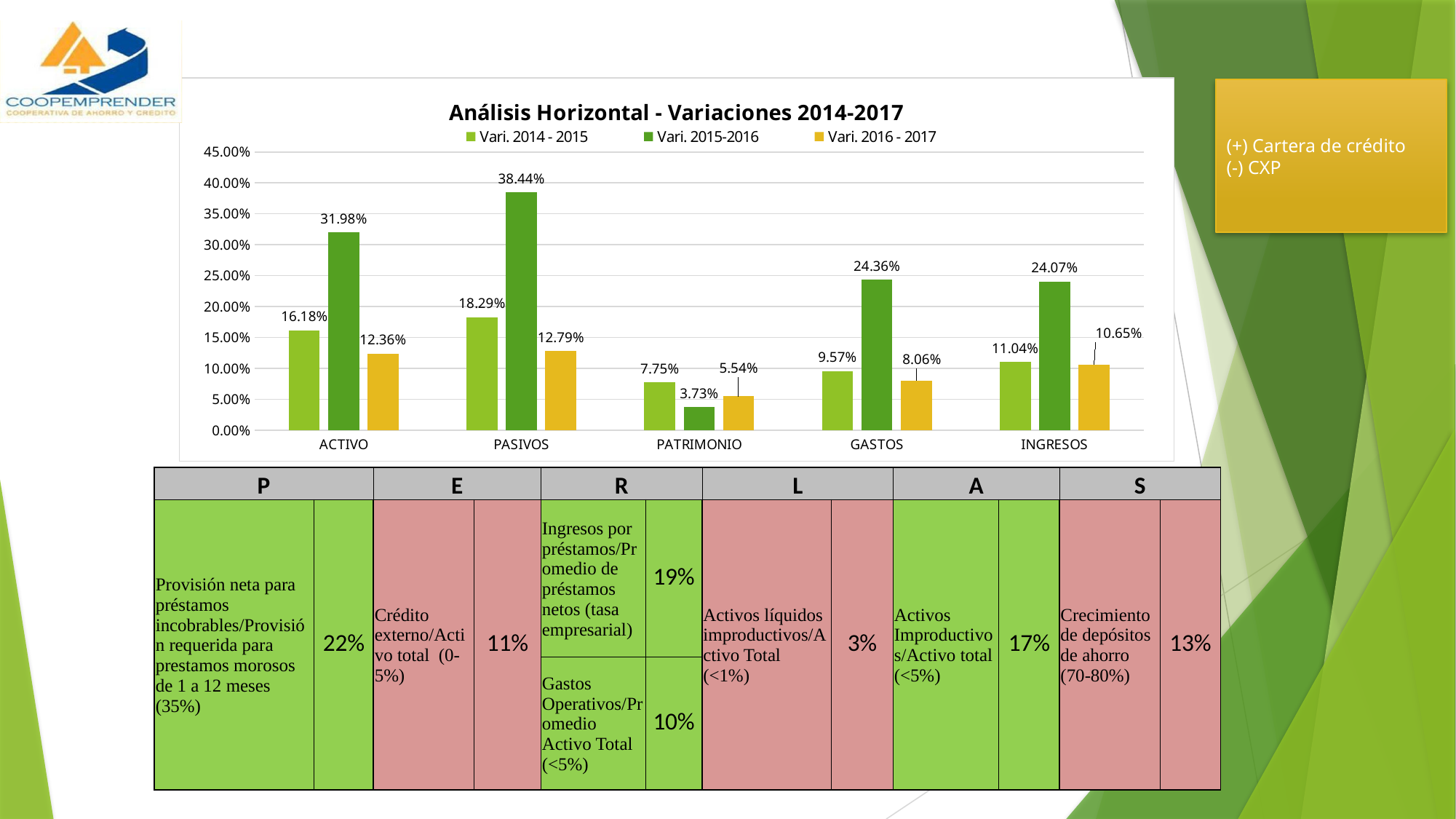
What is the Vari. 2015-2016 value for PATRIMONIO? 3.73% What kind of chart is shown on the slide? Bar chart What is the Vari. 2015-2016 value for PASIVOS? 38.44% Which is larger for GASTOS: the Vari. 2014 - 2015 value or the Vari. 2016 - 2017 value? Vari. 2014 - 2015 Which category has the highest Vari. 2015-2016 value? PASIVOS What is the Vari. 2016 - 2017 value for INGRESOS? 10.65% What is the difference between the Vari. 2015-2016 values for PASIVOS and ACTIVO? 6.46% How many series does the chart legend list? 3 What is the Vari. 2014 - 2015 value for ACTIVO? 16.18% What is the title of the chart? Análisis Horizontal - Variaciones 2014-2017 Which category has the lowest Vari. 2014 - 2015 value? PATRIMONIO How many categories are shown on the x axis of the chart? 5